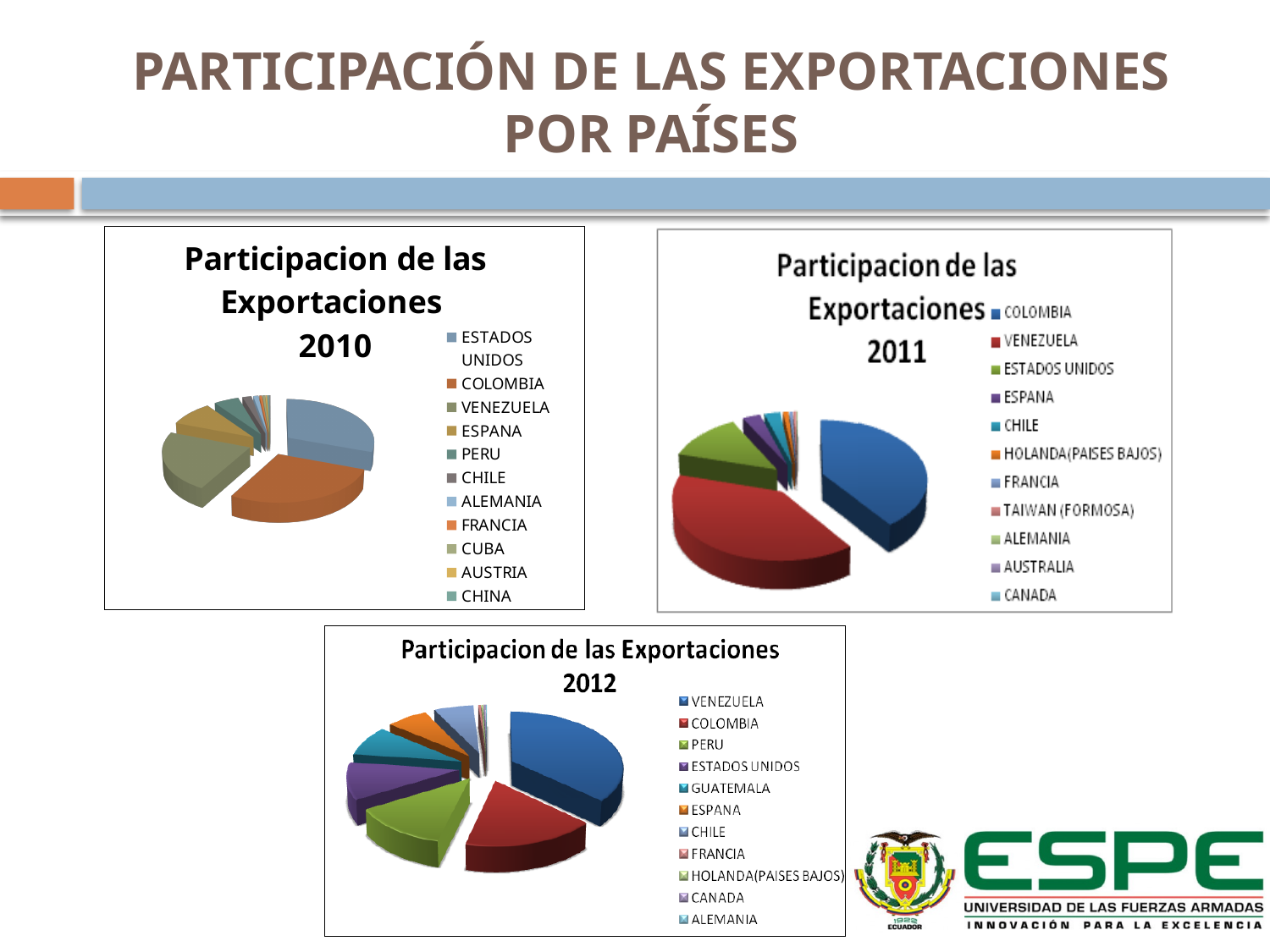
How many pie charts are shown on the slide? 3 In the 'Participacion de las Exportaciones 2010' chart, which slice is larger: ESTADOS UNIDOS or VENEZUELA? ESTADOS UNIDOS In the 'Participacion de las Exportaciones 2012' chart, which slice is larger: VENEZUELA or PERU? VENEZUELA In the 'Participacion de las Exportaciones 2012' chart, which country has the largest slice? VENEZUELA How many countries does the legend of the 'Participacion de las Exportaciones 2010' chart list? 11 What kind of chart is the 'Participacion de las Exportaciones 2010' chart? Pie chart Which country is listed first in the legend of the 'Participacion de las Exportaciones 2011' chart? COLOMBIA In the 'Participacion de las Exportaciones 2012' chart, which slice is larger: COLOMBIA or ALEMANIA? COLOMBIA How many countries does the legend of the 'Participacion de las Exportaciones 2012' chart list? 11 In the 'Participacion de las Exportaciones 2011' chart, which country has the largest slice? COLOMBIA